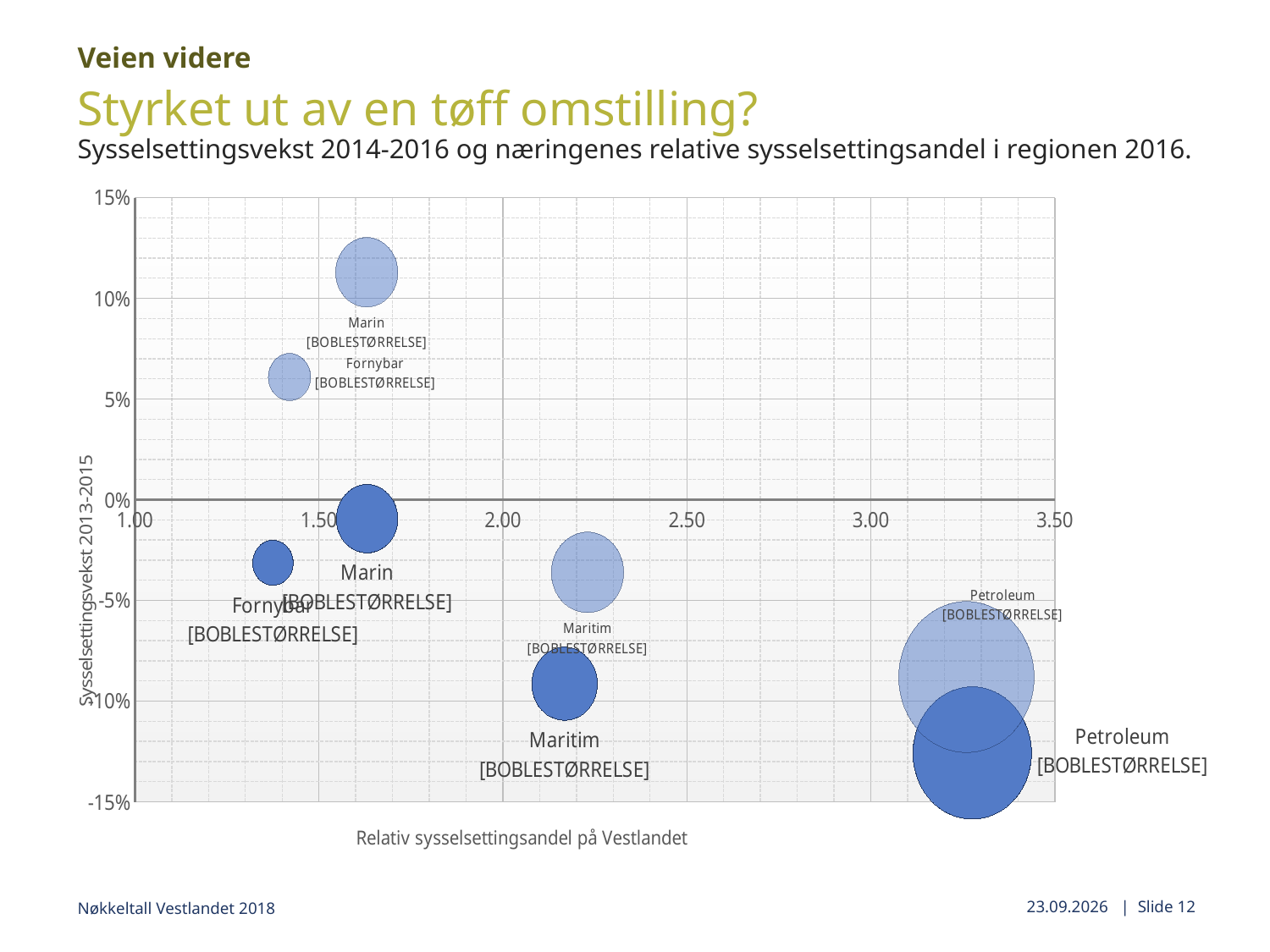
How many bubbles are plotted in the chart? 8 Is the x value of the Petroleum bubbles greater or less than 3.00? greater Is the y value of the light blue Fornybar bubble greater or less than 5%? greater Which industry's bubbles are positioned furthest to the right on the x axis? Petroleum Is the y value of the light blue Marin bubble greater or less than 10%? greater Which is positioned higher on the y axis: the light blue Marin bubble or the light blue Fornybar bubble? Marin What is the title of the x axis? Relativ sysselsettingsandel på Vestlandet How many industries are labelled in the chart? 4 What kind of chart is shown on the slide? bubble chart Which light blue bubble is positioned highest on the y axis? Marin Which dark blue bubble is positioned lowest on the y axis? Petroleum